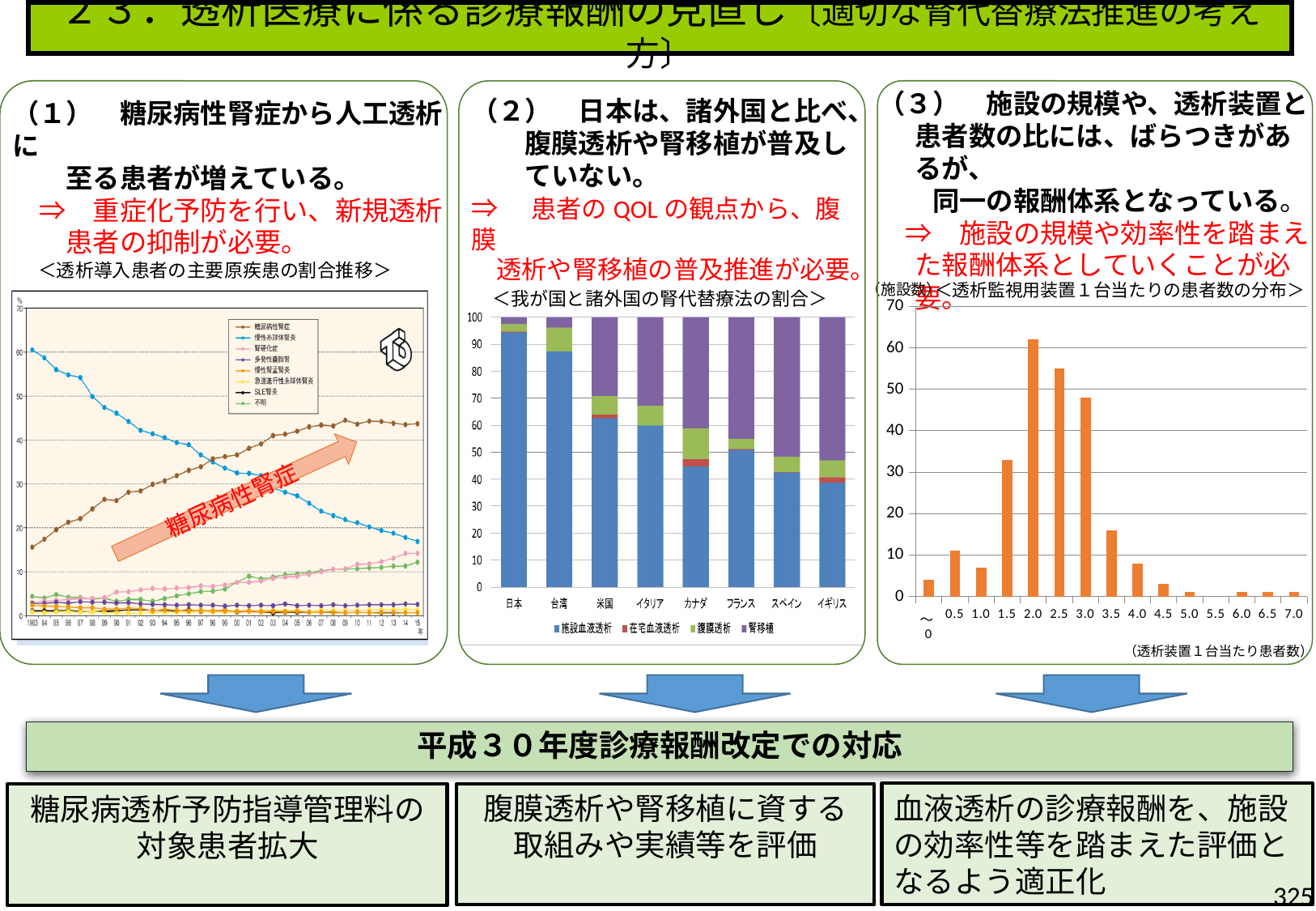
In the chart titled 透析導入患者の主要原疾患の割合推移 on the left of the slide, does the 糖尿病性腎症 line rise or fall over the years? rise In the chart titled 透析監視用装置１台当たりの患者数の分布, is the value for 1.5 greater or less than 30? greater In the chart titled 透析監視用装置１台当たりの患者数の分布, which is larger, the value for 2.5 or the value for 3.0? 2.5 In the chart titled 透析監視用装置１台当たりの患者数の分布, which category on the x axis has the highest bar? 2.0 In the chart titled 我が国と諸外国の腎代替療法の割合, which country has the highest share of 施設血液透析? 日本 In the chart titled 透析監視用装置１台当たりの患者数の分布, is the value for 2.0 greater or less than 60? greater What kind of chart is the chart titled 透析監視用装置１台当たりの患者数の分布 on the right of the slide? bar chart What kind of chart is the chart titled 我が国と諸外国の腎代替療法の割合 in the middle of the slide? stacked bar chart How many series does the legend list in the chart titled 我が国と諸外国の腎代替療法の割合? 4 How many countries are shown on the x axis of the chart titled 我が国と諸外国の腎代替療法の割合? 8 In the chart titled 我が国と諸外国の腎代替療法の割合, is the 施設血液透析 share for 日本 greater or less than 90? greater